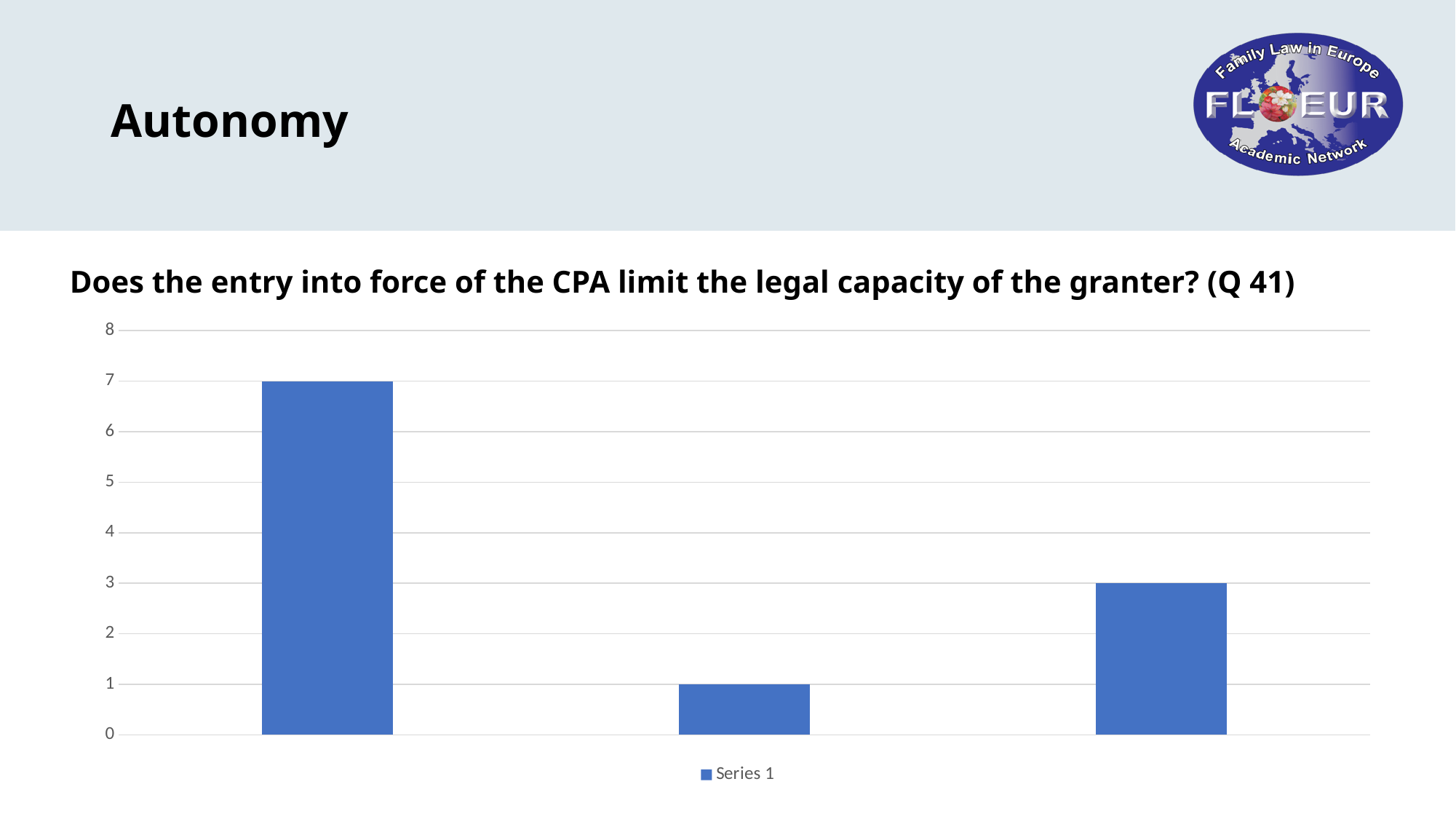
What is the name of the series shown in the legend? Series 1 What is the highest value shown on the vertical axis? 8 How many bars are plotted in the chart? 3 How many series does the legend list? 1 Which is larger, the middle bar or the rightmost bar? the rightmost bar What is the value of the leftmost bar? 7 What type of chart is shown on the slide? bar chart Which bar is the tallest: the left, middle or right one? left What is the difference between the leftmost bar and the rightmost bar? 4 What is the value of the rightmost bar? 3 Which bar is the shortest: the left, middle or right one? middle What is the value of the middle bar? 1